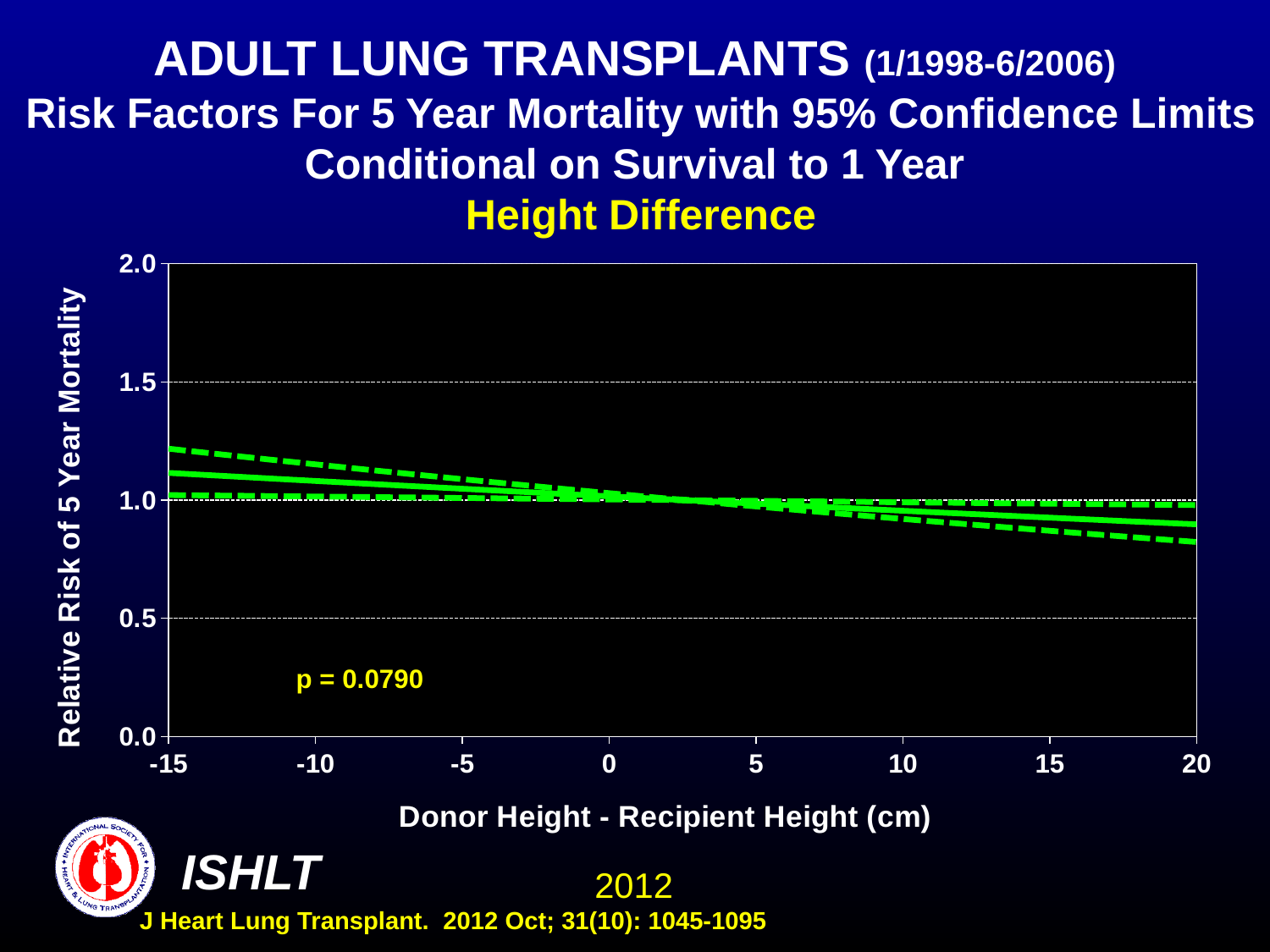
At which end of the x axis does the solid line reach its lowest relative risk? 20 cm Is the lower confidence limit at a height difference of 20 cm greater or less than 1.0? less Is the relative risk on the solid line at a height difference of -15 cm greater or less than 1.0? greater Does the relative risk of 5 year mortality rise or fall as the donor-recipient height difference increases from -15 to 20 cm? fall Which has the higher relative risk on the solid line: a height difference of -15 cm or 20 cm? -15 cm What kind of chart is shown on the slide? line chart At which end of the x axis does the solid line reach its highest relative risk? -15 cm Is the upper confidence limit at a height difference of -15 cm greater or less than 1.5? less What p-value is printed on the chart? p = 0.0790 How many lines are plotted on the chart (including the confidence limits)? 3 What is the label of the x axis? Donor Height - Recipient Height (cm)